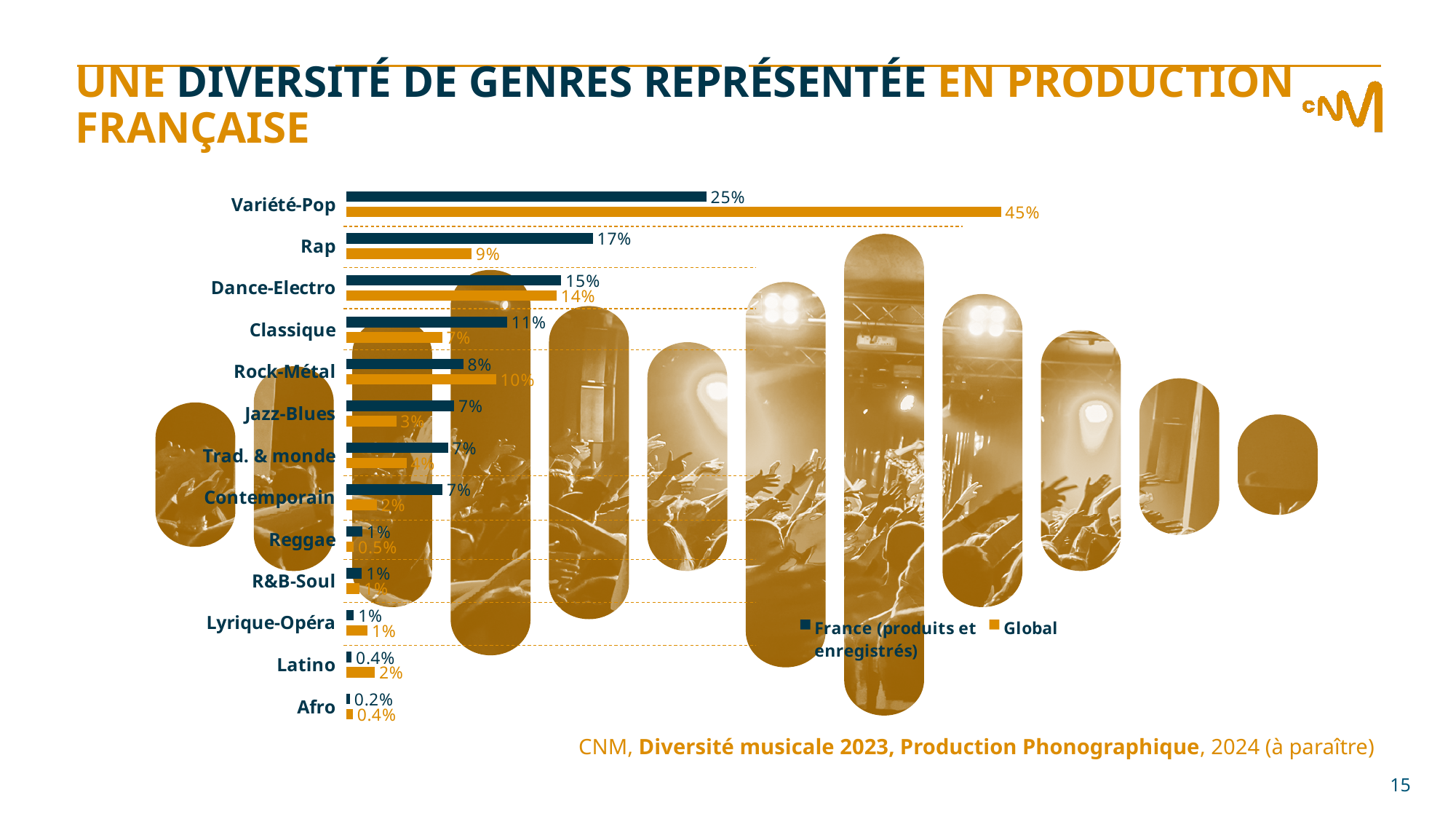
For Rap, which is larger: the France (produits et enregistrés) value or the Global value? France (produits et enregistrés) What is the Global value for Rock-Métal? 10% What is the Global value for Variété-Pop? 45% How many series does the legend list? 2 What is the Global value for Rap? 9% Which genre has the lowest France (produits et enregistrés) value? Afro What type of chart is shown on the slide? Bar chart How many genres are shown in the chart? 13 What is the France (produits et enregistrés) value for Dance-Electro? 15% What is the difference between the Global and France (produits et enregistrés) values for Variété-Pop? 20% What is the France (produits et enregistrés) value for Variété-Pop? 25% Which genre has the highest France (produits et enregistrés) value? Variété-Pop